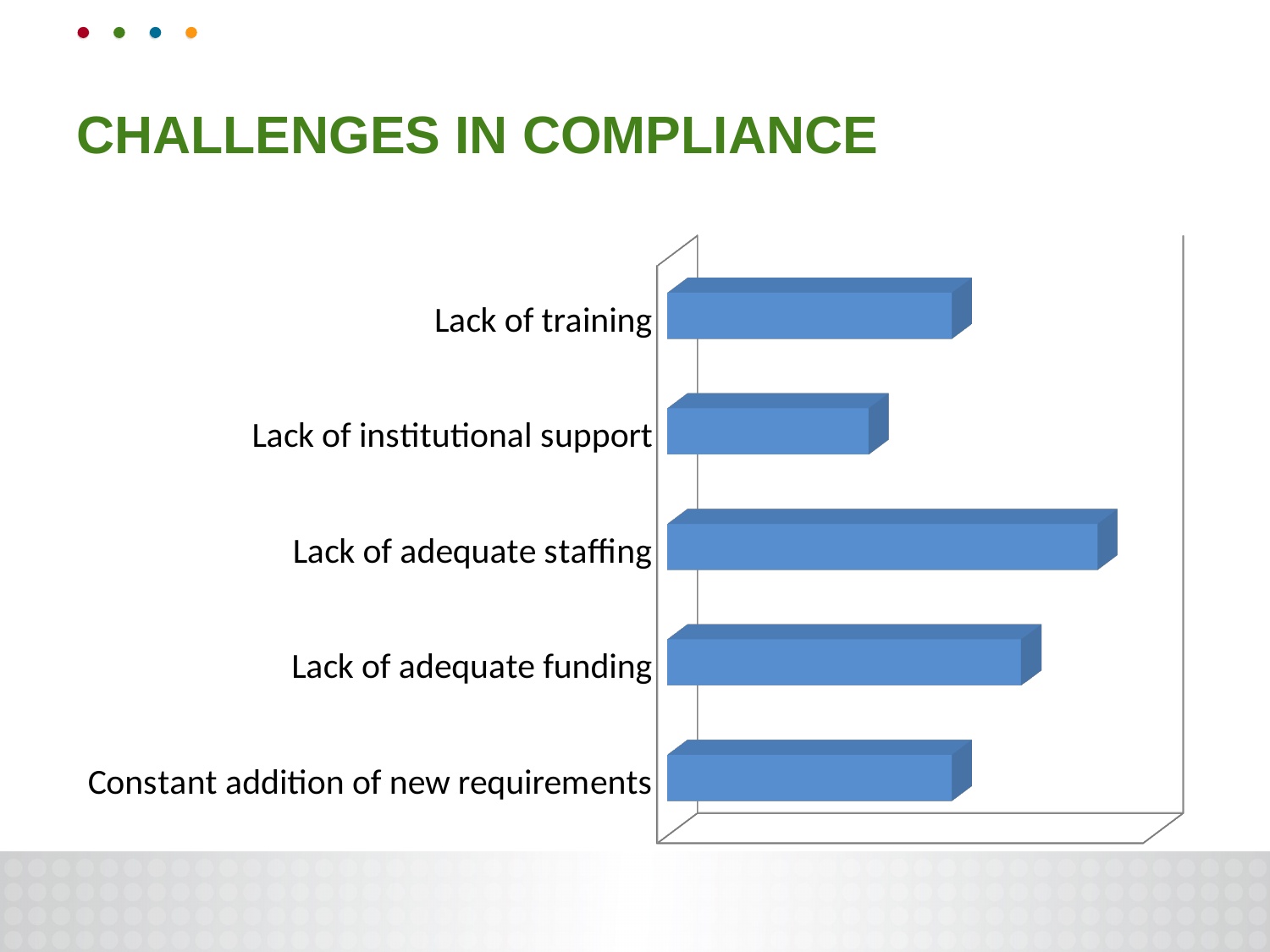
Which is larger, the value for Lack of adequate funding or the value for Lack of training? Lack of adequate funding How many categories are shown in the chart? 5 Which category has the shortest bar? Lack of institutional support Which is larger, the value for Lack of adequate funding or the value for Constant addition of new requirements? Lack of adequate funding What colour are the bars in the chart? blue Which category has the longest bar? Lack of adequate staffing What kind of chart is shown on the slide? bar chart Which is larger, the value for Lack of adequate staffing or the value for Lack of adequate funding? Lack of adequate staffing What is the title of the slide containing the chart? CHALLENGES IN COMPLIANCE